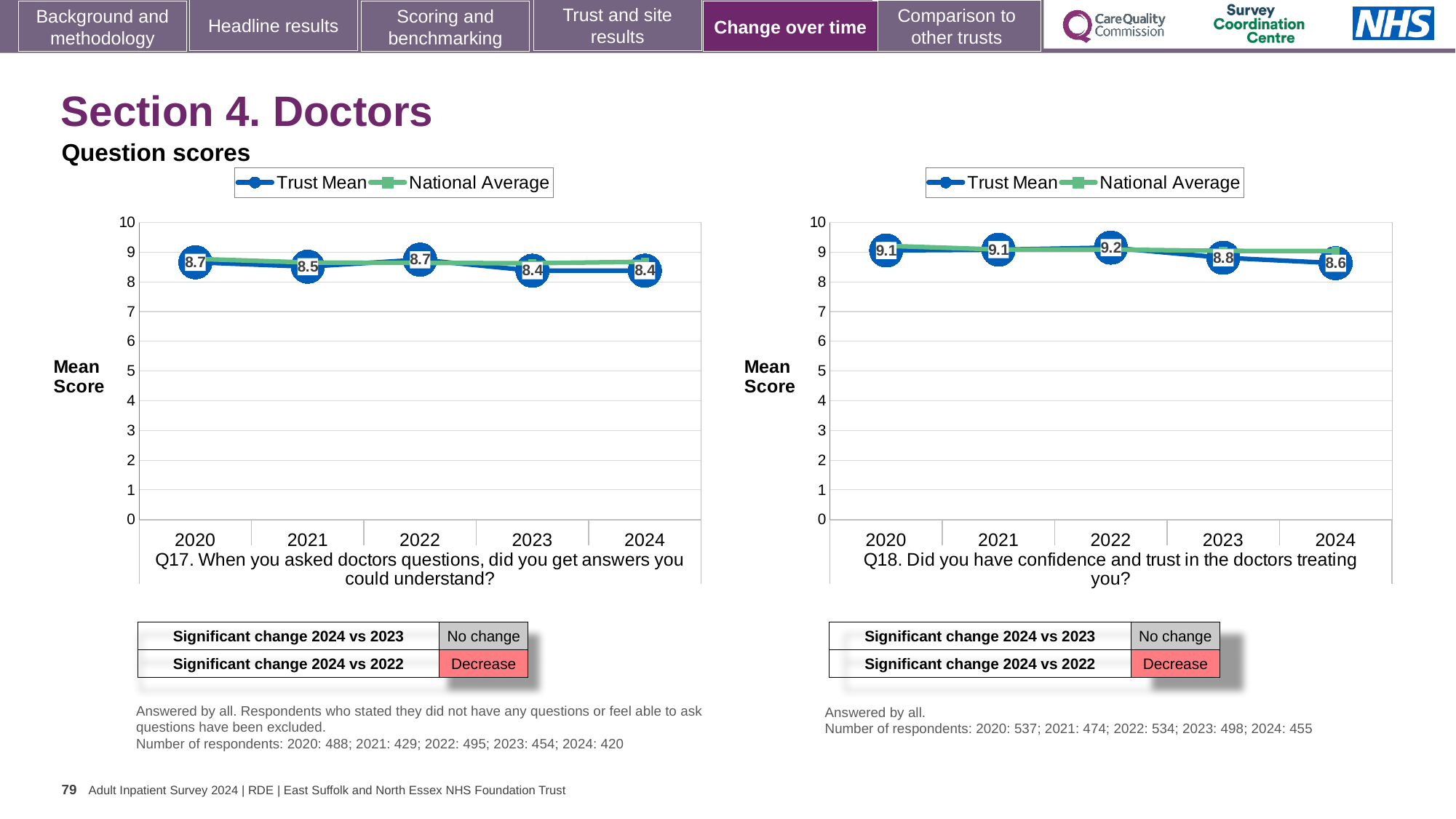
How many years are plotted on the x axis of the Q17 chart (left)? 5 In the Q18 chart (right), what is the Trust Mean for 2024? 8.6 In the Q17 chart (left), what is the Trust Mean for 2023? 8.4 In the Q18 chart (right), which year has the highest Trust Mean? 2022 In the Q18 chart (right), what is the Trust Mean for 2022? 9.2 In the Q18 chart (right), what is the difference between the Trust Mean in 2022 and in 2024? 0.6 In the Q18 chart (right), which year has the lowest Trust Mean? 2024 What type of chart is used for Q18 (right)? Line chart How many series does the legend of the Q18 chart (right) list? 2 In the Q17 chart (left), what is the difference between the Trust Mean in 2020 and in 2024? 0.3 In the Q17 chart (left), what is the Trust Mean for 2020? 8.7 In the Q17 chart (left), is the Trust Mean higher in 2021 or in 2022? 2022